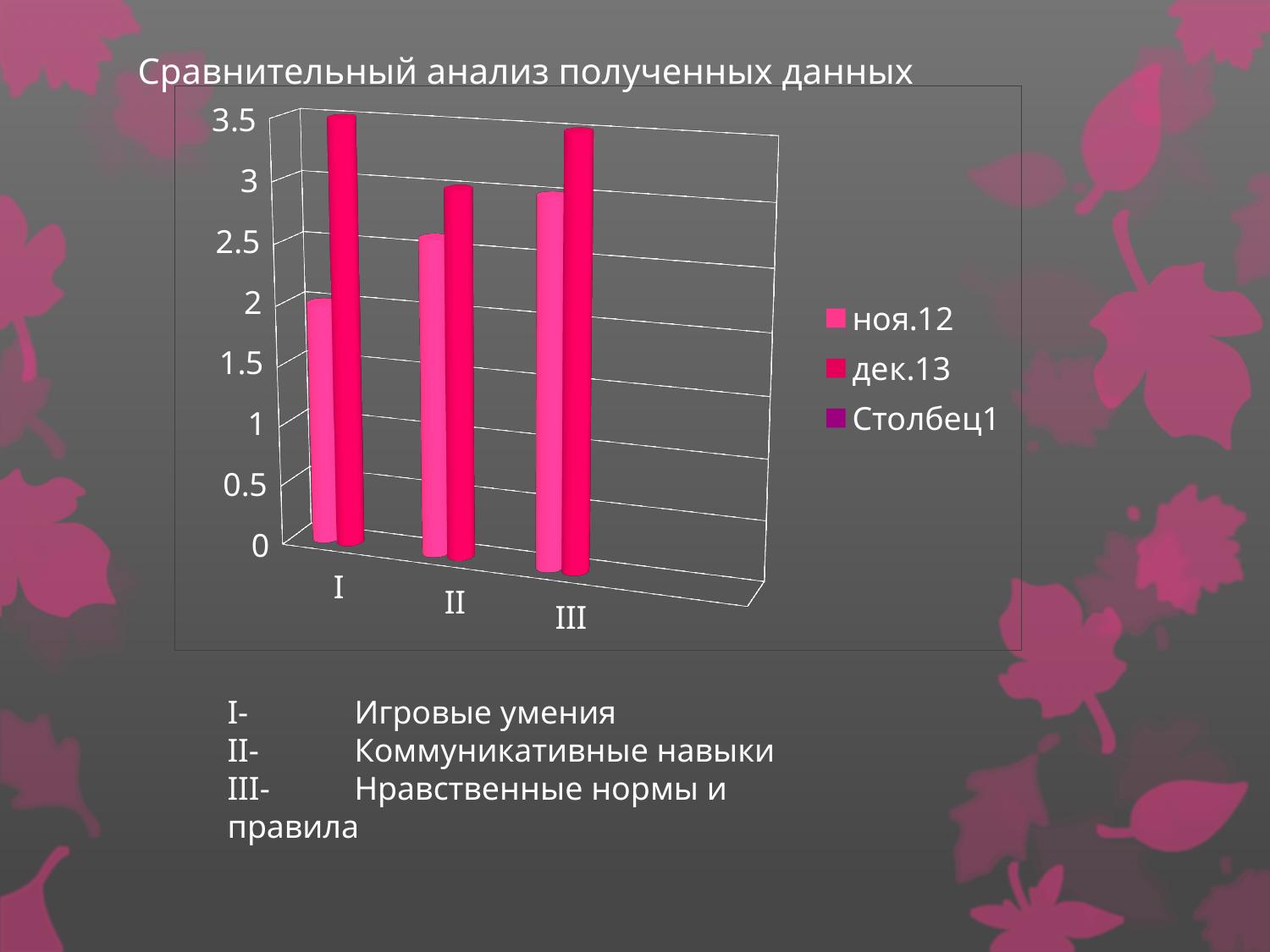
How many categories are shown on the x axis? 3 Is the value for дек.13 in category III greater or less than 3? greater Which category has the highest value for the ноя.12 series? III Which category has the lowest value for the дек.13 series? II Do the ноя.12 values rise or fall from category I to category III? rise Is the value for дек.13 in category I greater or less than 3? greater How many series does the legend list? 3 Is the value for ноя.12 in category II greater or less than 2? greater In category I, which series has the larger value, ноя.12 or дек.13? дек.13 What kind of chart is shown on the slide? bar chart Which category has the lowest value for the ноя.12 series? I